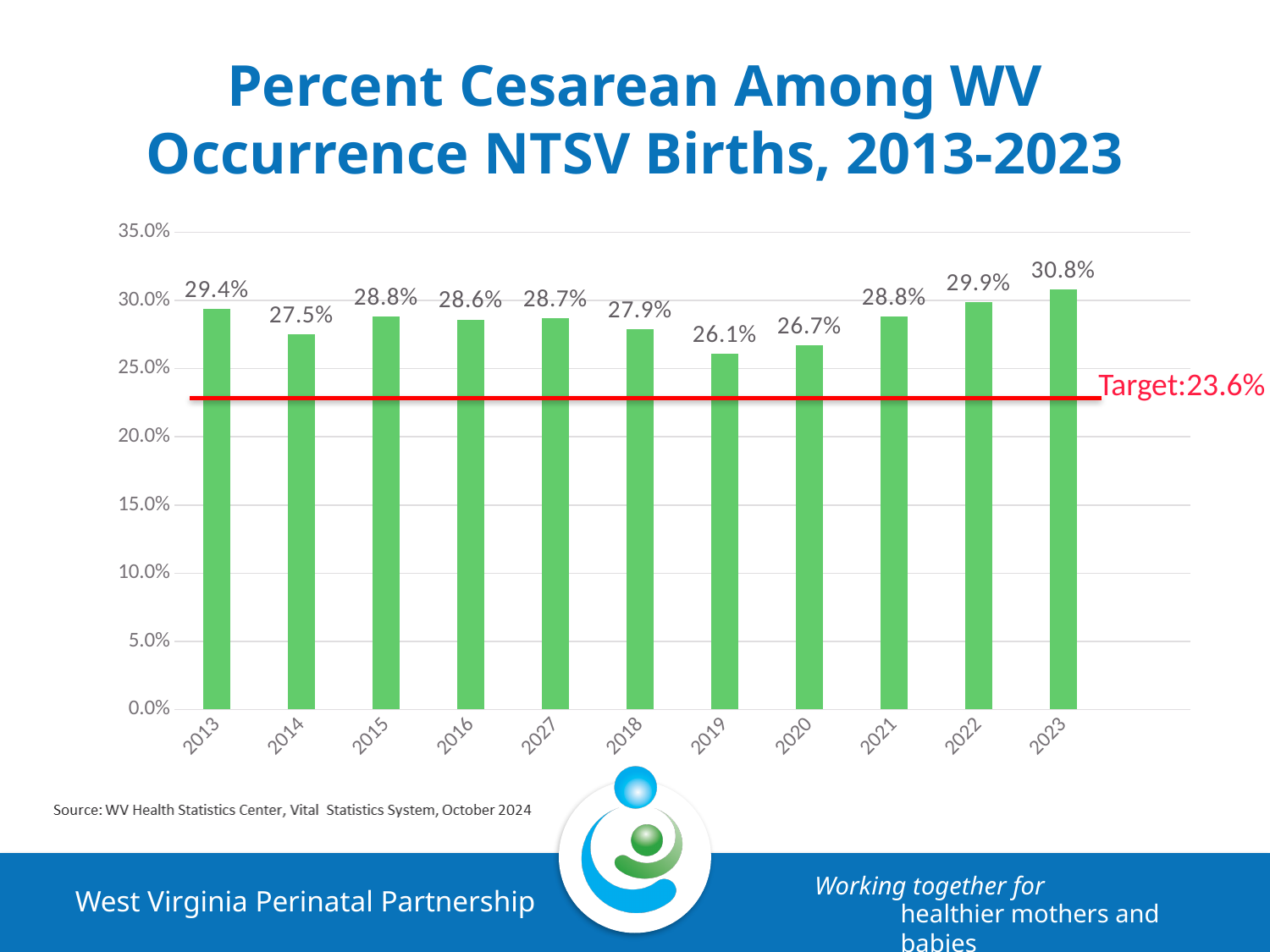
Which year has the highest percent cesarean? 2023 What kind of chart is shown on the slide? bar chart What is the difference between the 2023 value and the 2019 value? 4.7 percentage points What is the difference between the 2013 value and the 2014 value? 1.9 percentage points What is the value shown for 2023? 30.8% How many years are plotted on the chart? 11 What target value is marked by the red line on the chart? 23.6% Which year has a larger value, 2021 or 2022? 2022 What is the value shown for 2019? 26.1% Is the value for 2020 greater or less than 25.0%? greater Which year has the lowest percent cesarean? 2019 What is the percent cesarean among WV occurrence NTSV births in 2013? 29.4%